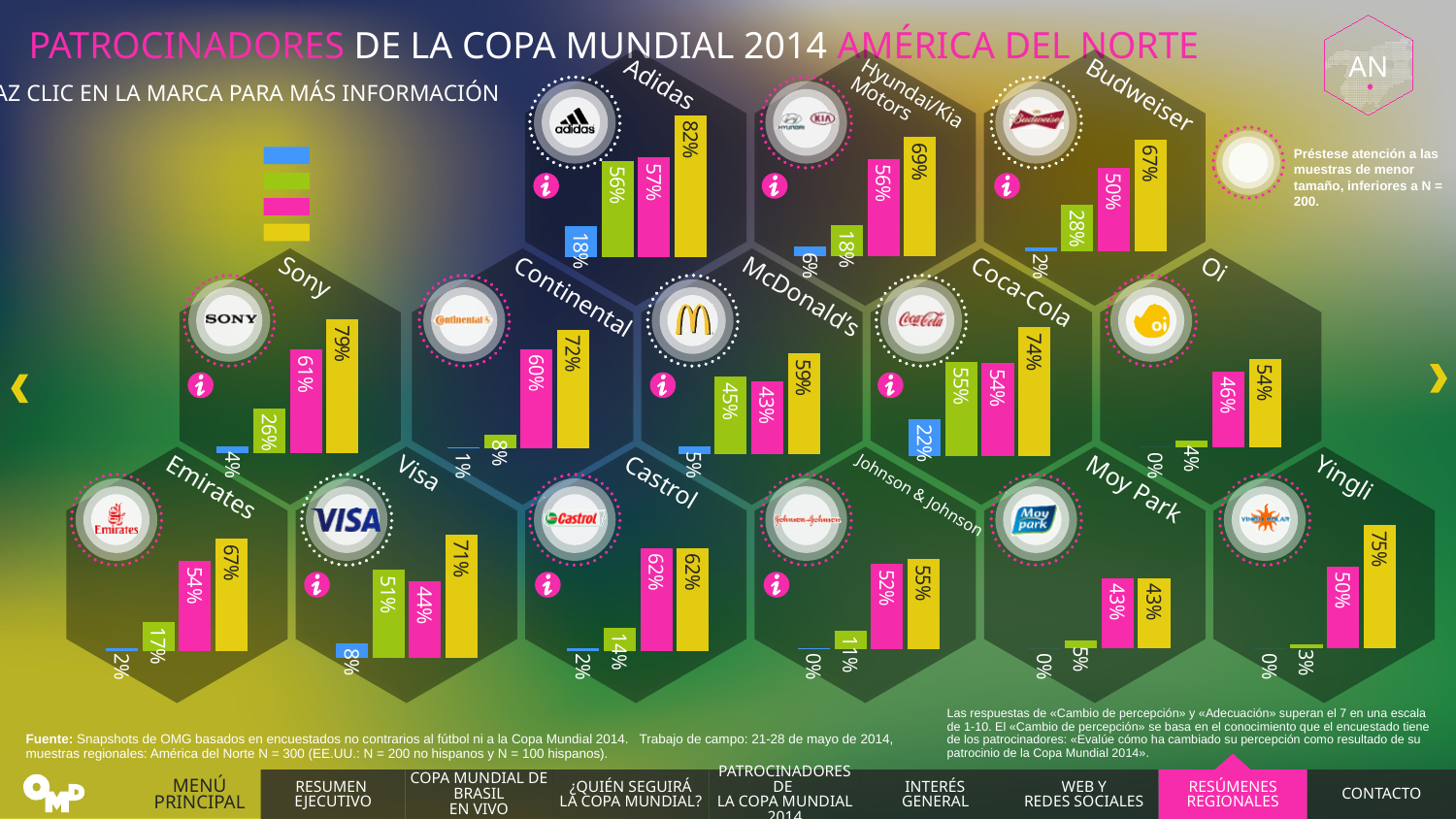
In the Continental chart, which bar has the lowest value? the blue bar (1%) In the Yingli chart, what value is shown on the green bar? 3% In the Castrol chart, what value do both the pink and yellow bars show? 62% How many bars does each sponsor chart contain? 4 Across all the sponsor charts, which sponsor has the highest yellow bar? Adidas How many sponsor charts are shown on the slide? 14 In the Budweiser chart, what is the difference between the yellow bar and the pink bar? 17% What kind of chart is used for each sponsor? bar chart In the McDonald's chart, which is larger, the green bar or the pink bar? the green bar (45%) In the Sony chart, what value is shown on the pink bar? 61% In the Coca-Cola chart, what value is shown on the blue bar? 22% In the Adidas chart, what value is shown on the yellow bar? 82%